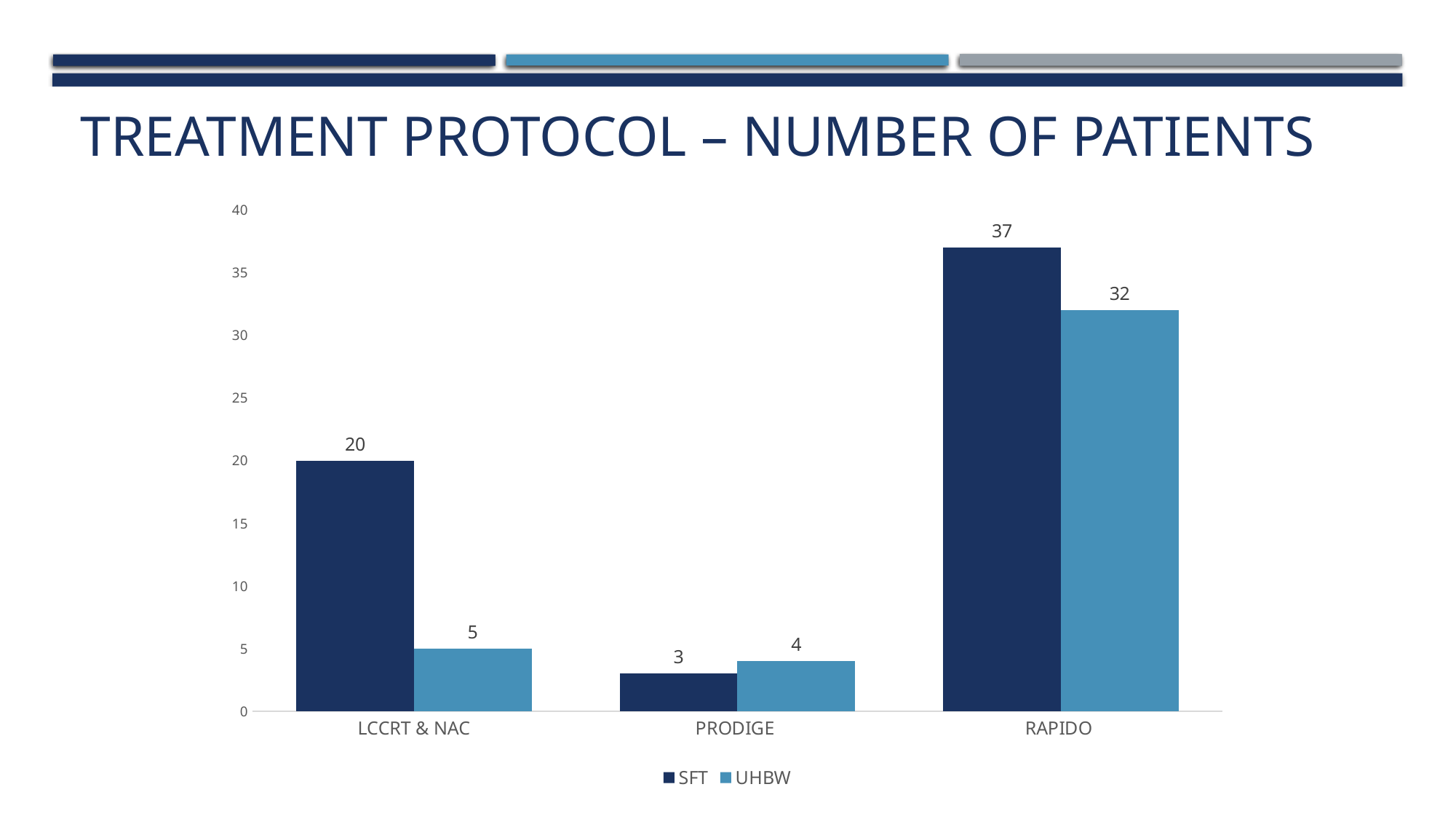
What kind of chart is shown on the slide? Bar chart How many series does the legend list? 2 How many treatment protocols are shown on the x axis? 3 What is the difference between the SFT and UHBW patient numbers for LCCRT & NAC? 15 What is the number of SFT patients for RAPIDO? 37 Which treatment protocol has the lowest number of SFT patients? PRODIGE What is the difference between the SFT and UHBW patient numbers for RAPIDO? 5 For PRODIGE, which series has more patients, SFT or UHBW? UHBW What is the number of SFT patients for PRODIGE? 3 What is the number of UHBW patients for LCCRT & NAC? 5 Which treatment protocol has the highest number of UHBW patients? RAPIDO What is the title of the slide? TREATMENT PROTOCOL – NUMBER OF PATIENTS